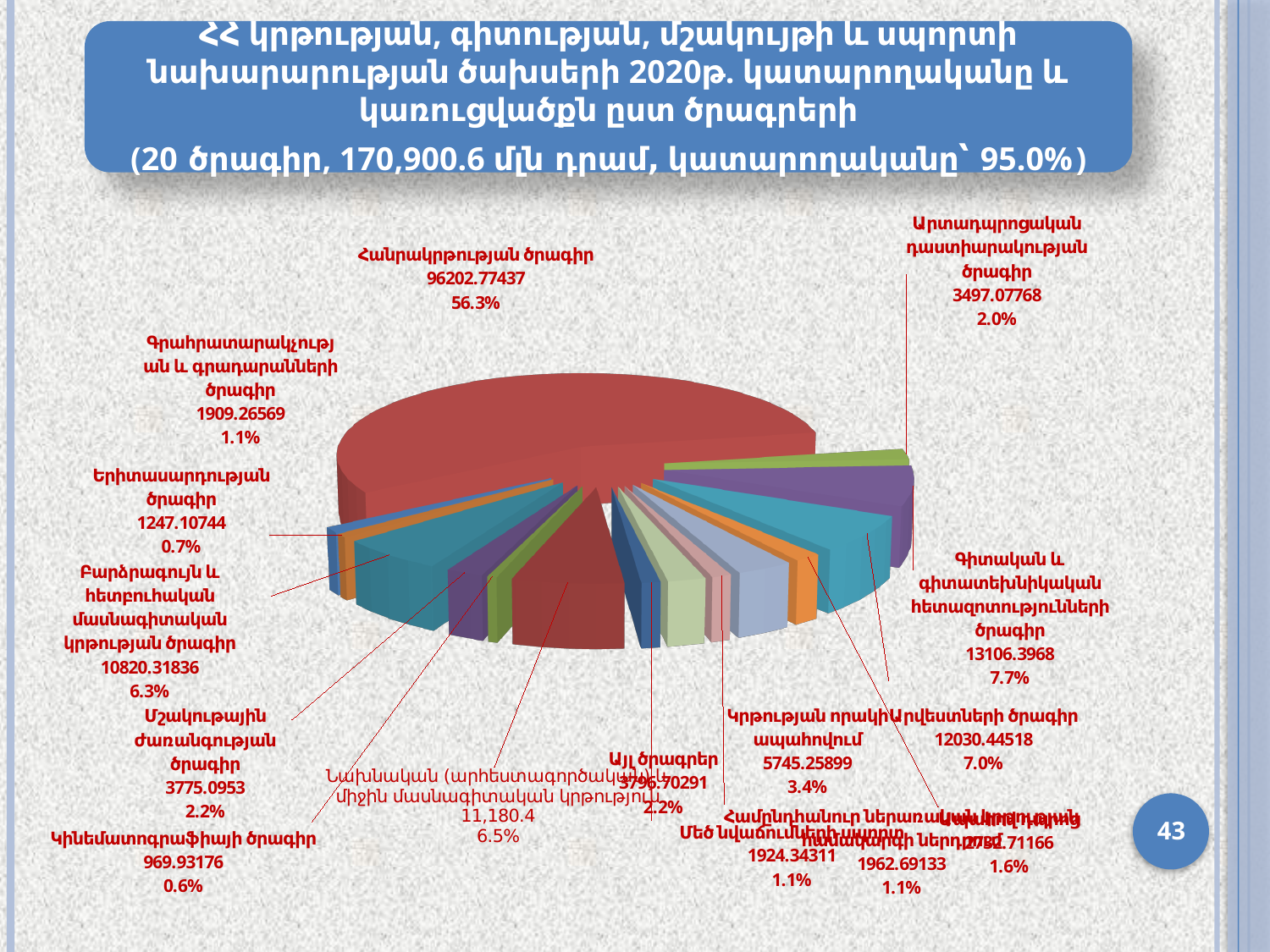
What kind of chart is shown on the slide? pie chart What percentage is shown for Կրթության որակի ապահովում? 3.4% What percentage is shown for Արտադպրոցական դաստիարակության ծրագիր? 2.0% Which is larger: Բարձրագույն և հետբուհական մասնագիտական կրթության ծրագիր or Արվեստների ծրագիր? Արվեստների ծրագիր Which program has the largest slice of the pie? Հանրակրթության ծրագիր What value is shown for Մշակութային ժառանգության ծրագիր? 3775.0953 What share of the pie does Հանրակրթության ծրագիր represent? 56.3% What value is shown for Գիտական և գիտատեխնիկական հետազոտությունների ծրագիր? 13106.3968 What value is shown for Երիտասարդության ծրագիր? 1247.10744 What value is shown for Հանրակրթության ծրագիր? 96202.77437 Which program has the smallest slice of the pie? Կինեմատոգրաֆիայի ծրագիր According to the title, how many programs are included in the chart? 20